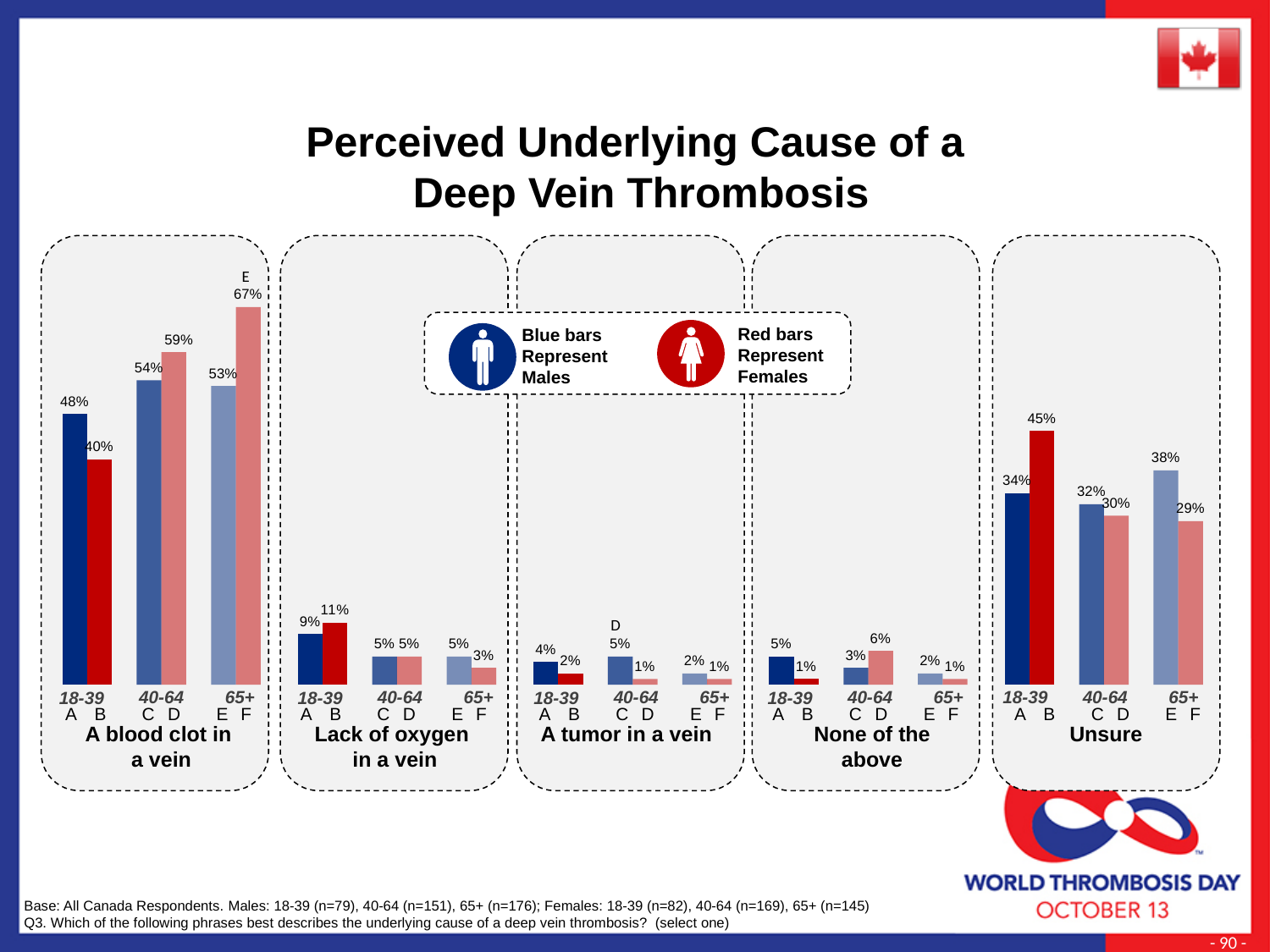
In the 'A tumor in a vein' panel, which is larger for the 40-64 group: males or females? Males How many answer-category panels are shown on the slide? 5 In the 'None of the above' panel, which is larger for the 40-64 group: males or females? Females In the 'A blood clot in a vein' panel, what percentage of females aged 65+ chose this answer? 67% In the 'A blood clot in a vein' panel, what is the difference between females 65+ and males 65+? 14 percentage points In the 'A blood clot in a vein' panel, what percentage of males aged 18-39 chose this answer? 48% In the 'A blood clot in a vein' panel, which age-and-gender group has the highest value? Females 65+ In the 'Lack of oxygen in a vein' panel, what percentage of females aged 18-39 chose this answer? 11% In the 'Unsure' panel, which age-and-gender group has the lowest value? Females 65+ In the 'Unsure' panel, what is the difference between females 18-39 and males 18-39? 11 percentage points What type of chart is used on this slide? Bar chart In the 'Unsure' panel, what percentage of females aged 18-39 were unsure? 45%